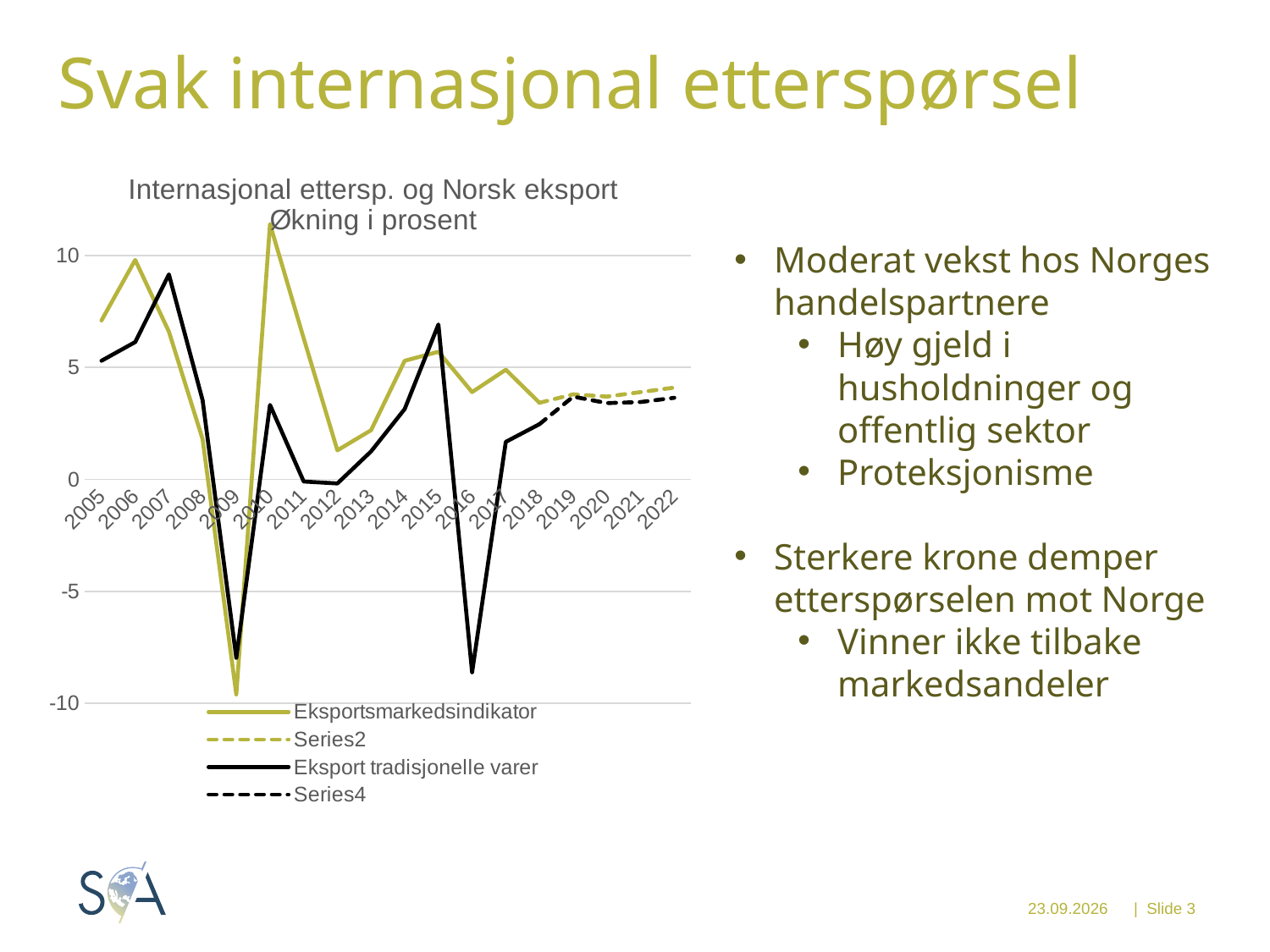
Is the value for Eksportmarkedsindikator in 2010 greater or less than 10? greater How many series does the chart legend list? 4 Which legend entries are drawn with dashed lines? Series2 and Series4 How many years are shown along the x axis of the chart? 18 What kind of chart is shown on the slide? line chart Is the value for Eksport tradisjonelle varer in 2007 greater or less than 5? greater In which year does Eksportmarkedsindikator reach its lowest value? 2009 What is the title of the chart? Internasjonal ettersp. og Norsk eksport Økning i prosent In 2016, which is larger: Eksportmarkedsindikator or Eksport tradisjonelle varer? Eksportmarkedsindikator Is the value for Eksport tradisjonelle varer in 2016 greater or less than -5? less Does Eksportmarkedsindikator rise or fall from 2006 to 2009? fall